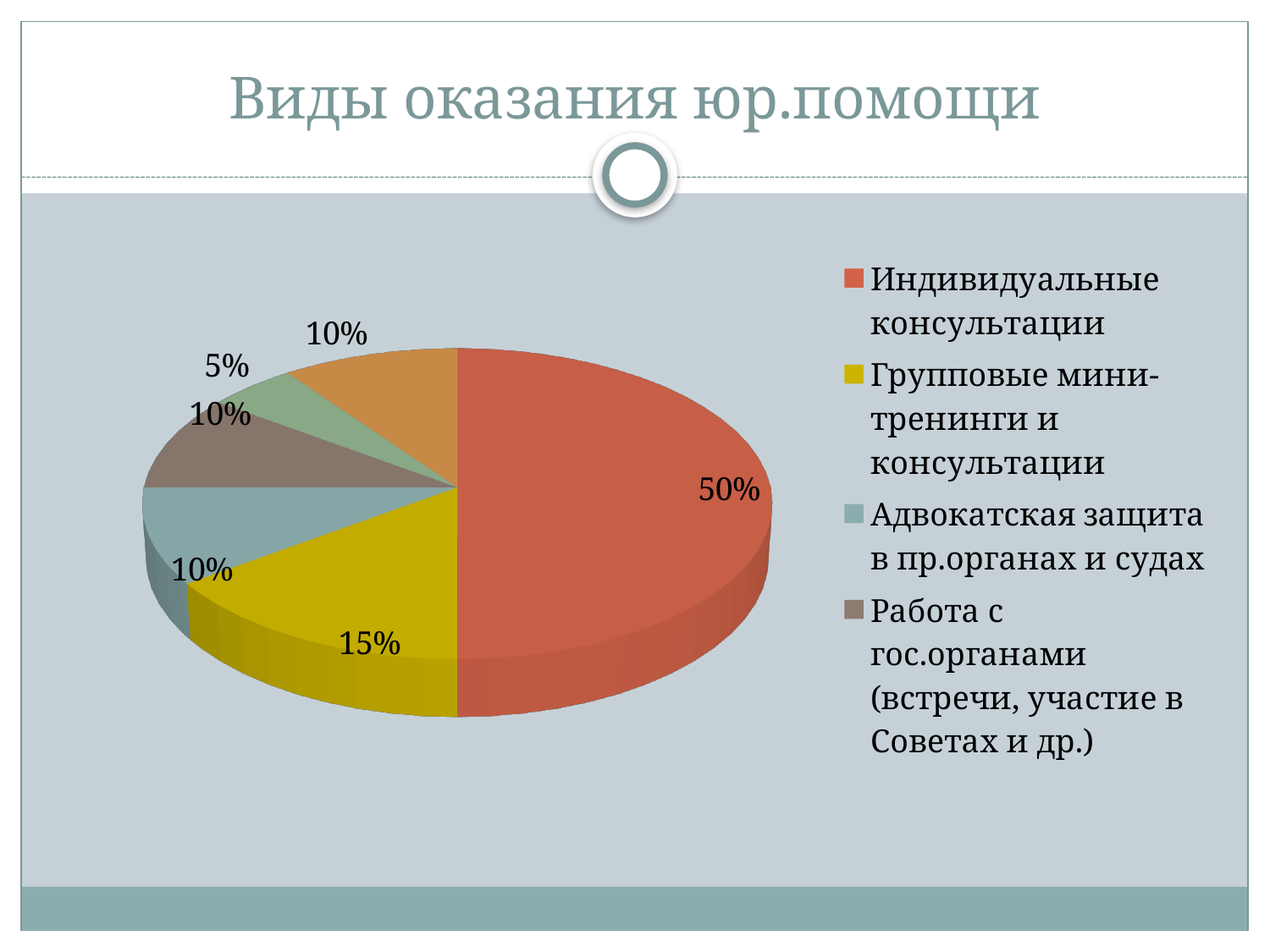
Which is larger: Групповые мини-тренинги и консультации or Адвокатская защита в пр.органах и судах? Групповые мини-тренинги и консультации What is the title of the chart on the slide? Виды оказания юр.помощи What percentage does the pie chart show for Индивидуальные консультации? 50% What kind of chart is shown on the slide? pie chart What is the smallest percentage labelled on the pie chart? 5% What percentage does the pie chart show for Групповые мини-тренинги и консультации? 15% What colour is the slice for Индивидуальные консультации? red What percentage does the pie chart show for Адвокатская защита в пр.органах и судах? 10% What percentage does the pie chart show for Работа с гос.органами? 10% By how many percentage points does Индивидуальные консультации exceed Групповые мини-тренинги и консультации? 35% Which category has the largest slice of the pie? Индивидуальные консультации How many slices does the pie chart have? 6